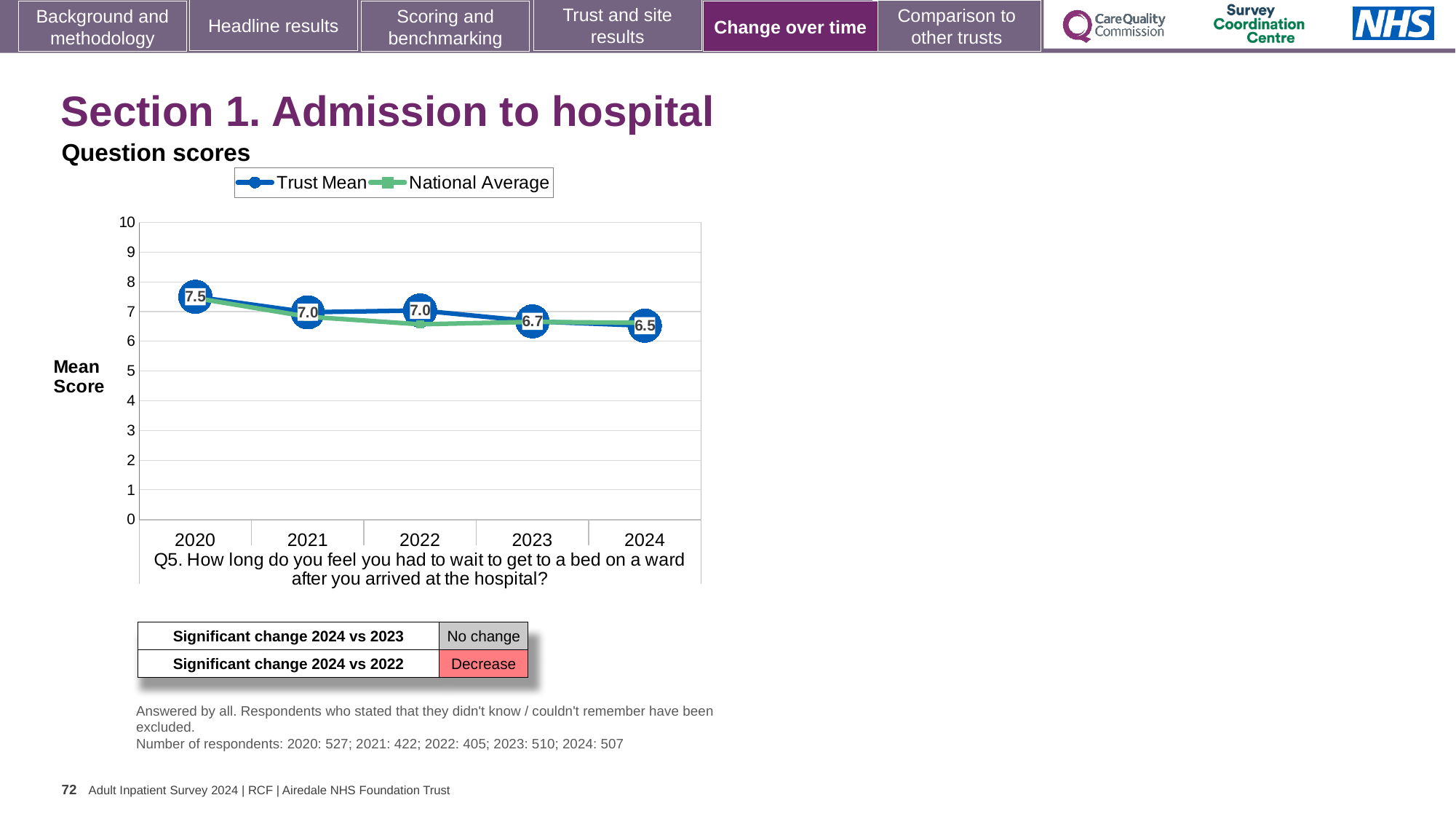
Which year has the larger Trust Mean, 2020 or 2023? 2020 How many series does the legend list? 2 In which year is the Trust Mean lowest? 2024 What kind of chart is shown? line chart In which year is the Trust Mean highest? 2020 What is the Trust Mean value for 2020? 7.5 What is the Trust Mean value for 2023? 6.7 What is the difference between the Trust Mean in 2020 and in 2024? 1.0 Does the Trust Mean rise or fall from 2020 to 2024? fall How many years are plotted on the x axis? 5 Is the National Average value for 2022 greater or less than 7? less What is the Trust Mean value for 2024? 6.5